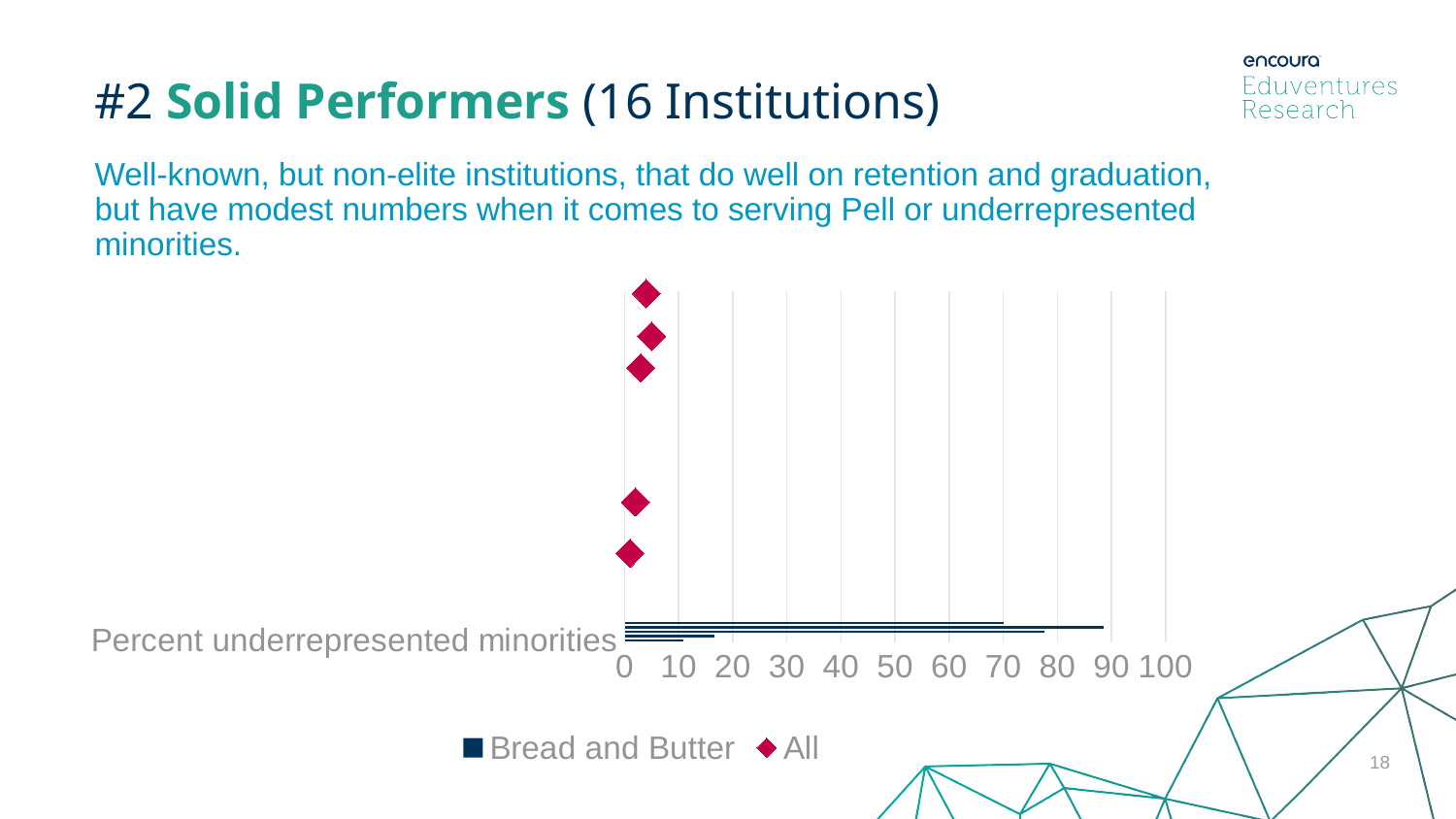
What is the category label shown on the chart's vertical axis? Percent underrepresented minorities What are the two series named in the chart legend? Bread and Butter and All Is the longest Bread and Butter bar greater or less than 80? greater What kind of chart is shown on the slide? bar chart What is the highest value labelled on the chart's x axis? 100 Is the longest Bread and Butter bar greater or less than 100? less Are the diamond markers for the All series greater or less than 10 on the x axis? less How many diamond markers for the All series are plotted on the chart? 5 Which series is plotted as bars, Bread and Butter or All? Bread and Butter How many series does the chart legend list? 2